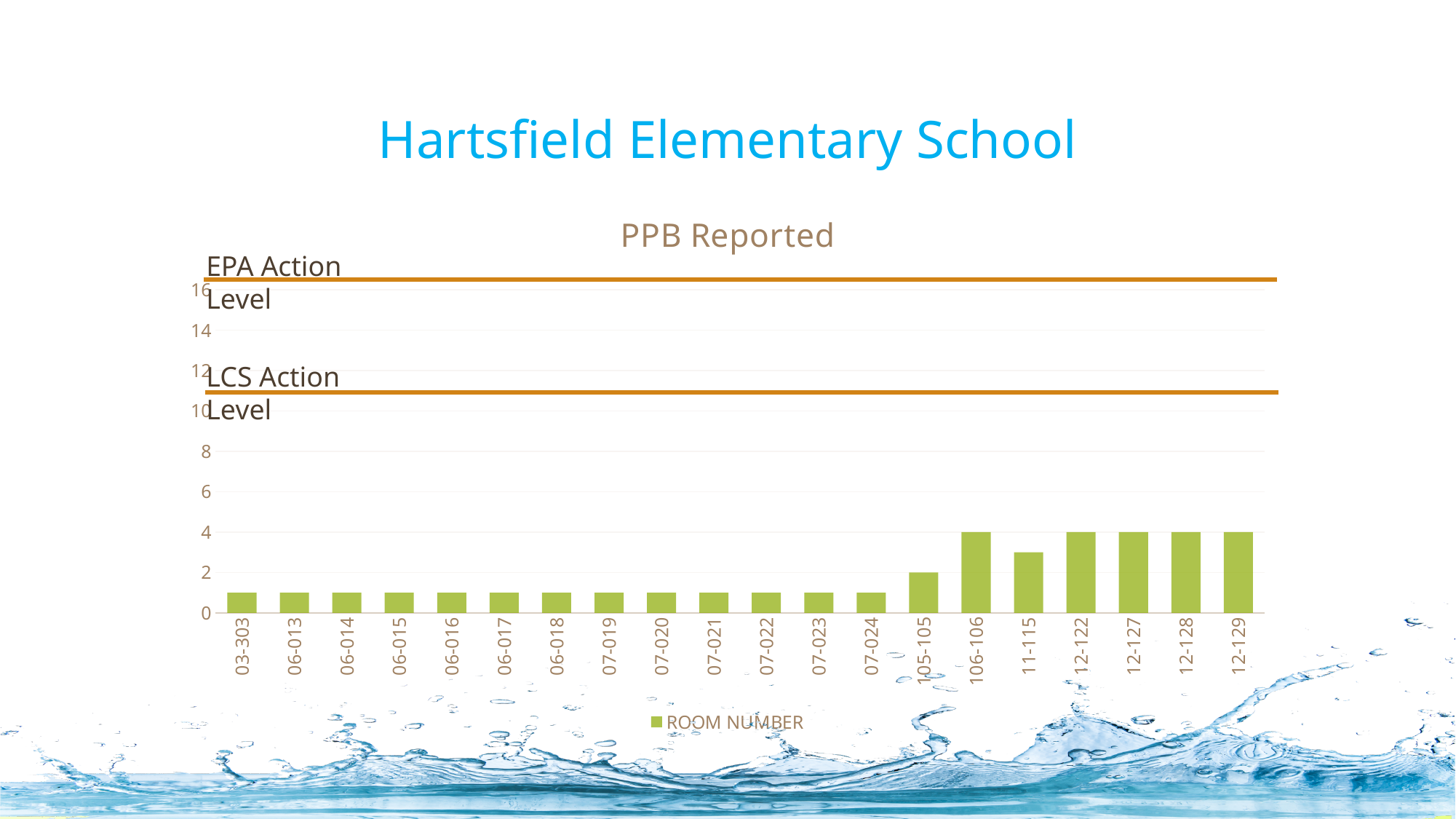
Which is larger, the value for 106-106 or the value for 11-115? 106-106 What type of chart is shown on the slide? bar chart How many categories (room numbers) are plotted on the x axis? 20 What is the name of the series shown in the legend? ROOM NUMBER What is the difference between the values for 106-106 and 105-105? 2 What is the value for 105-105? 2 What is the value for 12-129? 4 What is the title of the chart? PPB Reported Is the value for 03-303 greater or less than 2? less What is the value for 106-106? 4 How many series does the legend list? 1 Is the value for 11-115 greater or less than 2? greater